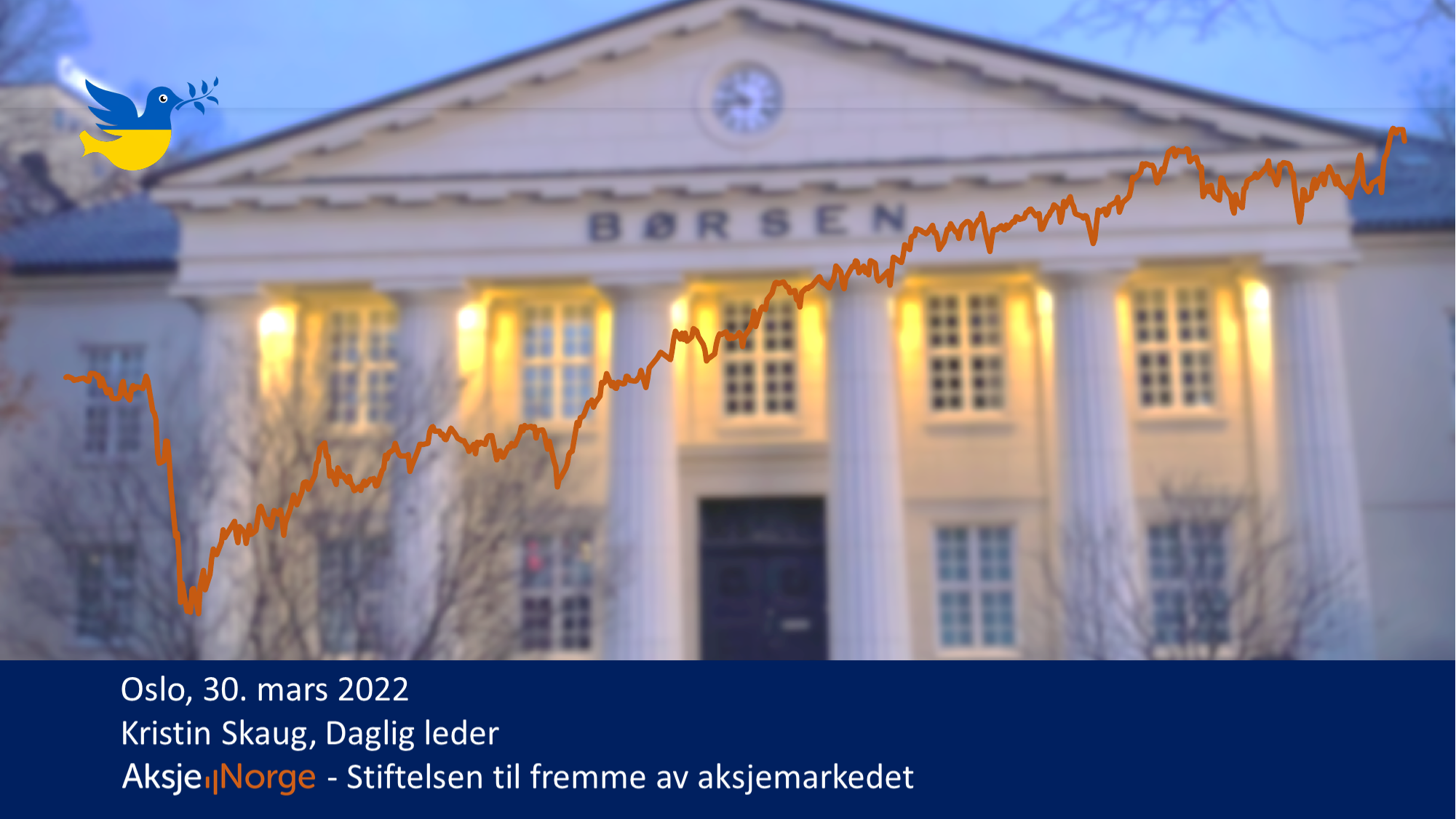
What colour is the plotted line? orange Is the lowest point of the line near the left end or the right end of the chart? near the left end What kind of chart is overlaid on the photo of the stock exchange building? line chart How many lines are plotted on the chart? 1 Overall, does the plotted line rise or fall from left to right? rise Does the chart show any axes, axis labels or a legend? no Is the highest point of the line near the left end or the right end of the chart? near the right end Does the line end higher or lower than where it starts on the left? higher